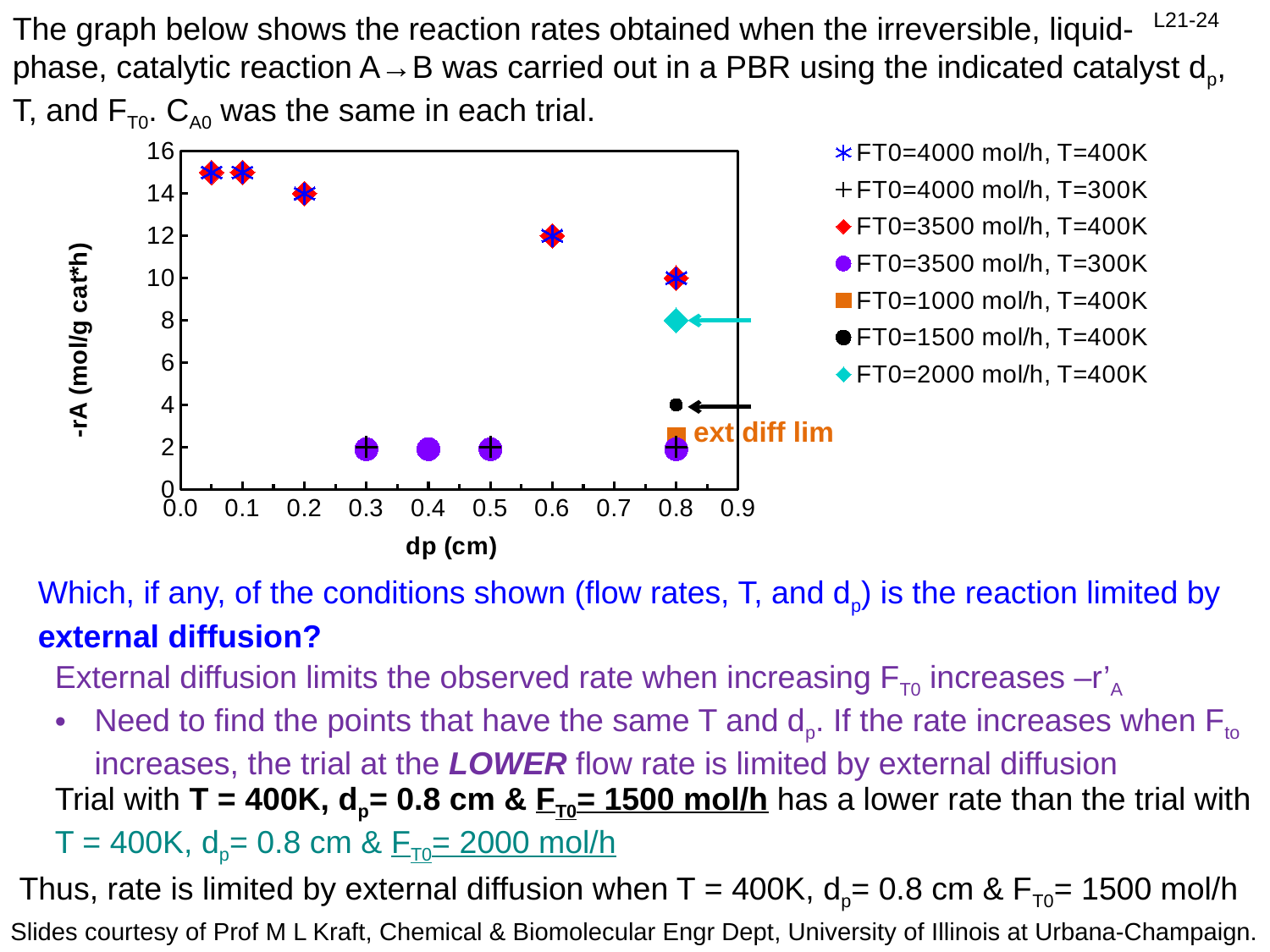
At dp = 0.8 cm, what is the difference in -rA between the FT0=2000 mol/h, T=400K point and the FT0=1500 mol/h, T=400K point? 4 How many data points are plotted for the FT0=3500 mol/h, T=300K series? 4 At dp = 0.8 cm, which has the larger -rA: the FT0=2000 mol/h, T=400K point or the FT0=1500 mol/h, T=400K point? FT0=2000 mol/h, T=400K What kind of chart is shown on the slide? scatter chart What is the label of the x axis of the chart? dp (cm) What is the -rA value for the FT0=4000 mol/h, T=400K point at dp = 0.6 cm? 12 What is the -rA value for the FT0=2000 mol/h, T=400K point at dp = 0.8 cm? 8 Is the -rA value for the FT0=1000 mol/h, T=400K point at dp = 0.8 cm greater or less than 4? less For the FT0=4000 mol/h, T=400K series, does -rA rise or fall as dp increases? fall Is the -rA value for the FT0=4000 mol/h, T=400K point at dp = 0.1 cm greater or less than 14? greater What is the -rA value for the FT0=1500 mol/h, T=400K point at dp = 0.8 cm? 4 How many series does the chart legend list? 7